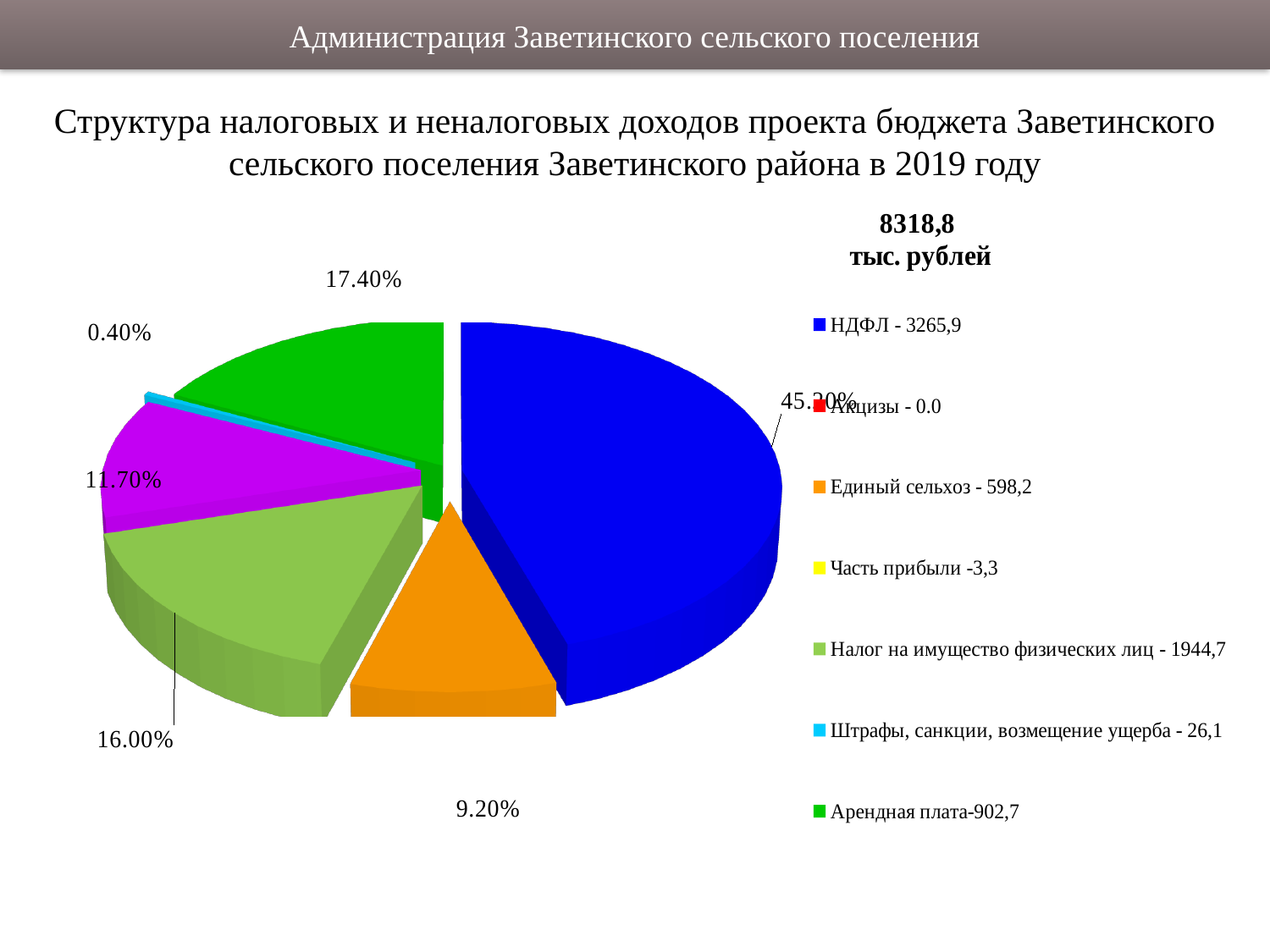
What is the difference between the labelled shares of Арендная плата (17.40%) and Единый сельхоз (9.20%)? 8.20% What total amount in тыс. рублей is shown above the legend? 8318,8 What percentage share is labelled on the Единый сельхоз (orange) slice? 9.20% What percentage share is labelled on the Арендная плата (green) slice? 17.40% What value is given in the legend for Арендная плата? 902,7 Which category has the largest slice of the pie? НДФЛ What value is given in the legend for НДФЛ? 3265,9 How many entries does the legend of the pie chart list? 7 Which is larger, the share for Арендная плата or the share for Единый сельхоз? Арендная плата What value is given in the legend for Налог на имущество физических лиц? 1944,7 What kind of chart is shown on the slide? pie chart What value is given in the legend for Штрафы, санкции, возмещение ущерба? 26,1